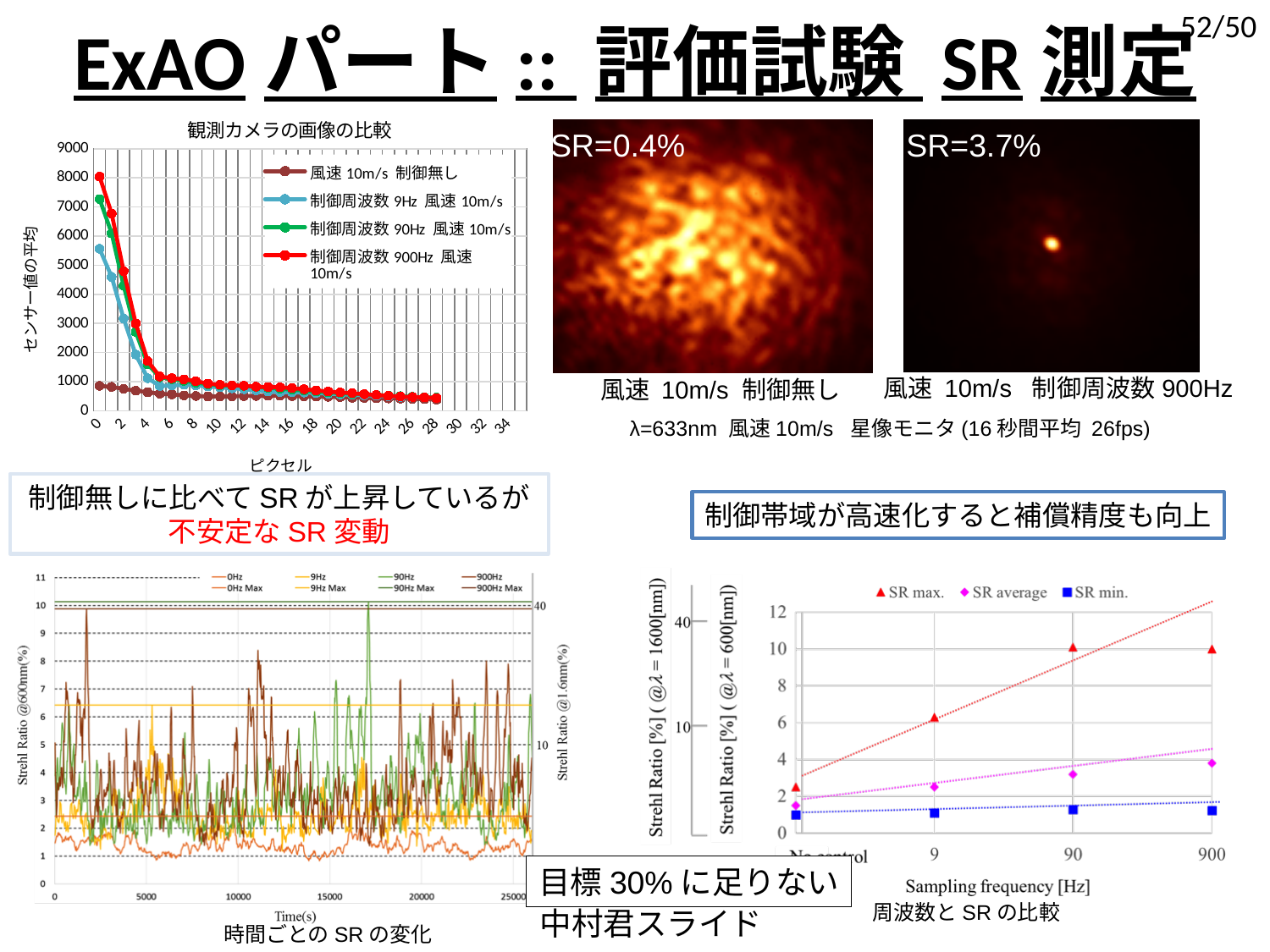
In the bottom-right chart (周波数とSRの比較), how many sampling-frequency categories are shown on the x axis? 4 In the top-left chart (観測カメラの画像の比較), which series has the highest value at x = 0? 制御周波数 900Hz 風速 10m/s In the top-left chart (観測カメラの画像の比較), which series has the lowest value at x = 0? 風速 10m/s 制御無し What is the x-axis label of the bottom-right chart (周波数とSRの比較)? Sampling frequency [Hz] What kind of chart is the top-left chart titled 観測カメラの画像の比較? line chart In the bottom-right chart (周波数とSRの比較), which is larger: the SR max. value at 9 Hz or the SR max. value at No control? 9 Hz In the top-left chart (観測カメラの画像の比較), is the value of the 制御周波数 900Hz 風速 10m/s series at x = 0 greater or less than 7000? greater In the top-left chart (観測カメラの画像の比較), do the values of the 制御周波数 900Hz 風速 10m/s series rise or fall as the x axis increases? fall How many series does the legend of the bottom-right chart (周波数とSRの比較) list? 3 How many series does the legend of the top-left chart (観測カメラの画像の比較) list? 4 In the bottom-right chart (周波数とSRの比較), is the SR max. value at a sampling frequency of 9 Hz greater or less than 4? greater In the top-left chart (観測カメラの画像の比較), is the value of the 風速 10m/s 制御無し series at x = 0 greater or less than 1000? less